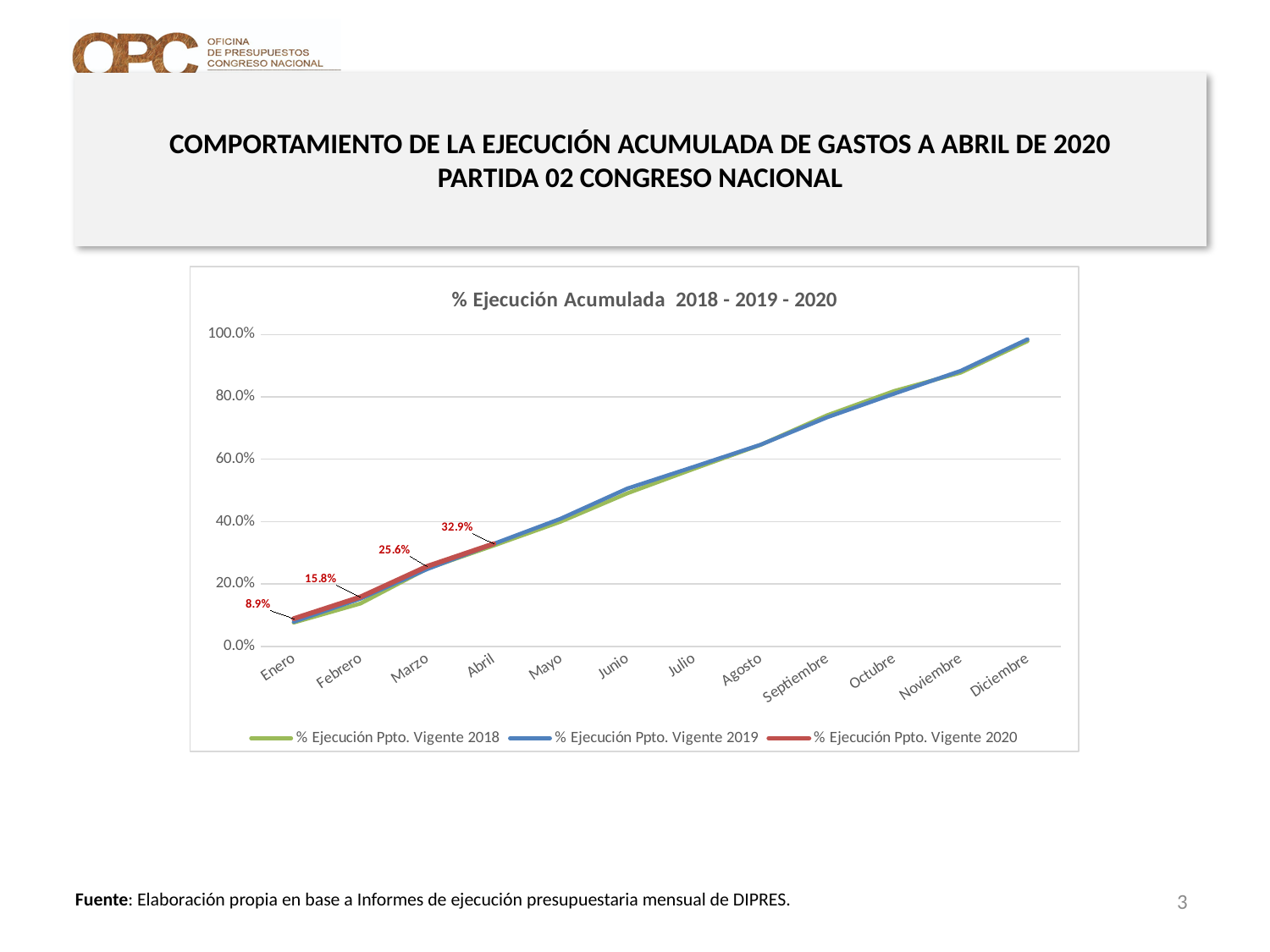
What is the value of % Ejecución Ppto. Vigente 2020 for Abril? 32.9% Is the value for % Ejecución Ppto. Vigente 2019 in Diciembre greater or less than 80.0%? greater What is the value of % Ejecución Ppto. Vigente 2020 for Febrero? 15.8% What is the difference between the 2020 values for Abril and Marzo? 7.3% How many series does the legend list? 3 Do the values rise or fall from Enero to Diciembre? Rise Which month has the highest labelled value for % Ejecución Ppto. Vigente 2020? Abril What is the value of % Ejecución Ppto. Vigente 2020 for Marzo? 25.6% How many months are shown on the x axis? 12 What is the difference between the 2020 values for Abril and Enero? 24.0% What kind of chart is shown on the slide? Line chart What is the value of % Ejecución Ppto. Vigente 2020 for Enero? 8.9%